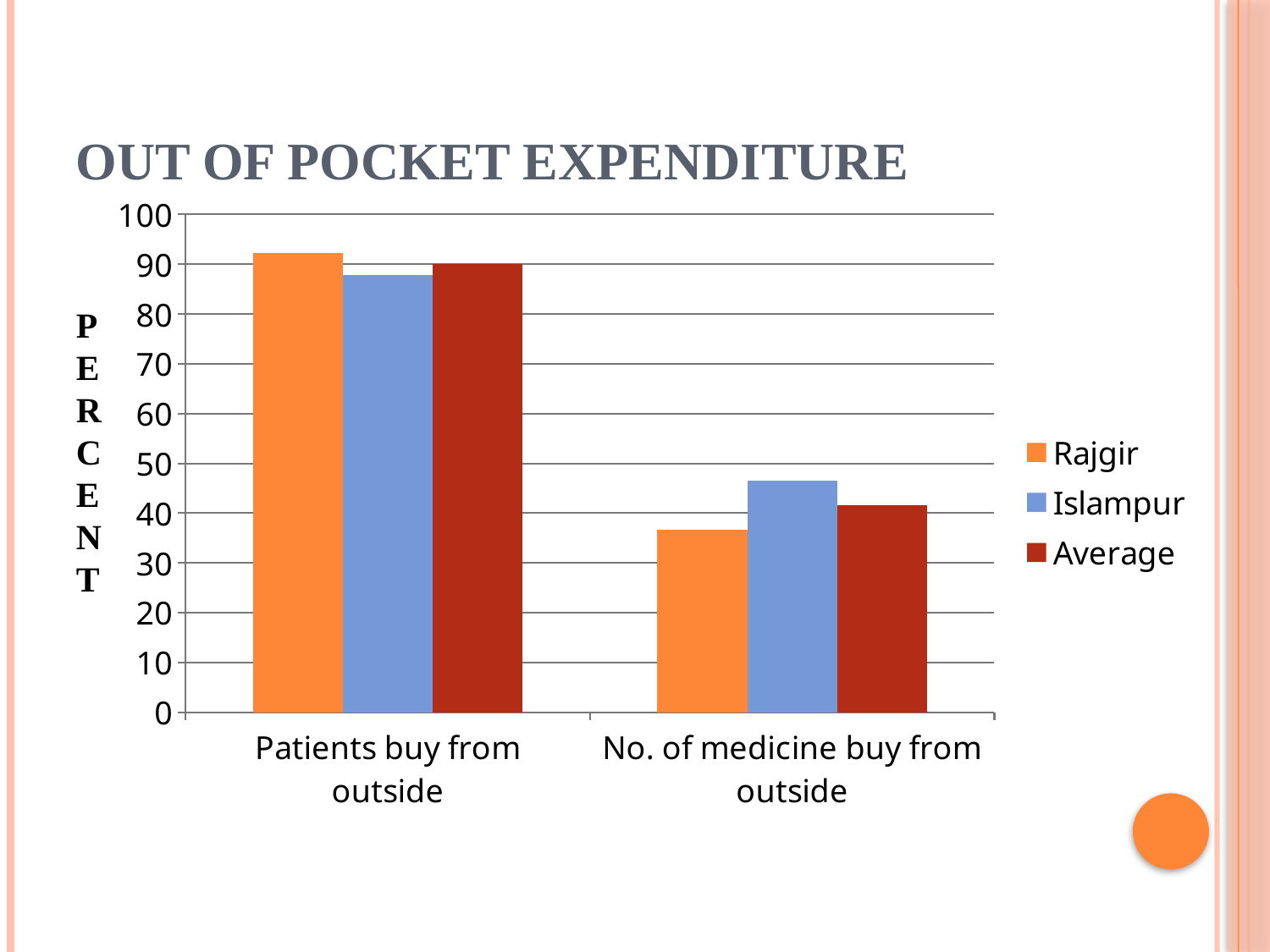
Is the value for Islampur in 'No. of medicine buy from outside' greater or less than 40? greater Which series has the highest value in 'Patients buy from outside'? Rajgir What label is shown on the vertical axis? PERCENT How many series does the legend list? 3 Which series has the lowest value in 'No. of medicine buy from outside'? Rajgir Is the value for Islampur in 'Patients buy from outside' greater or less than 90? less How many categories are shown on the x axis? 2 In 'No. of medicine buy from outside', which is larger: Rajgir or Islampur? Islampur Is the value for Rajgir in 'Patients buy from outside' greater or less than 90? greater What is the title of the chart? OUT OF POCKET EXPENDITURE What kind of chart is shown on the slide? bar chart